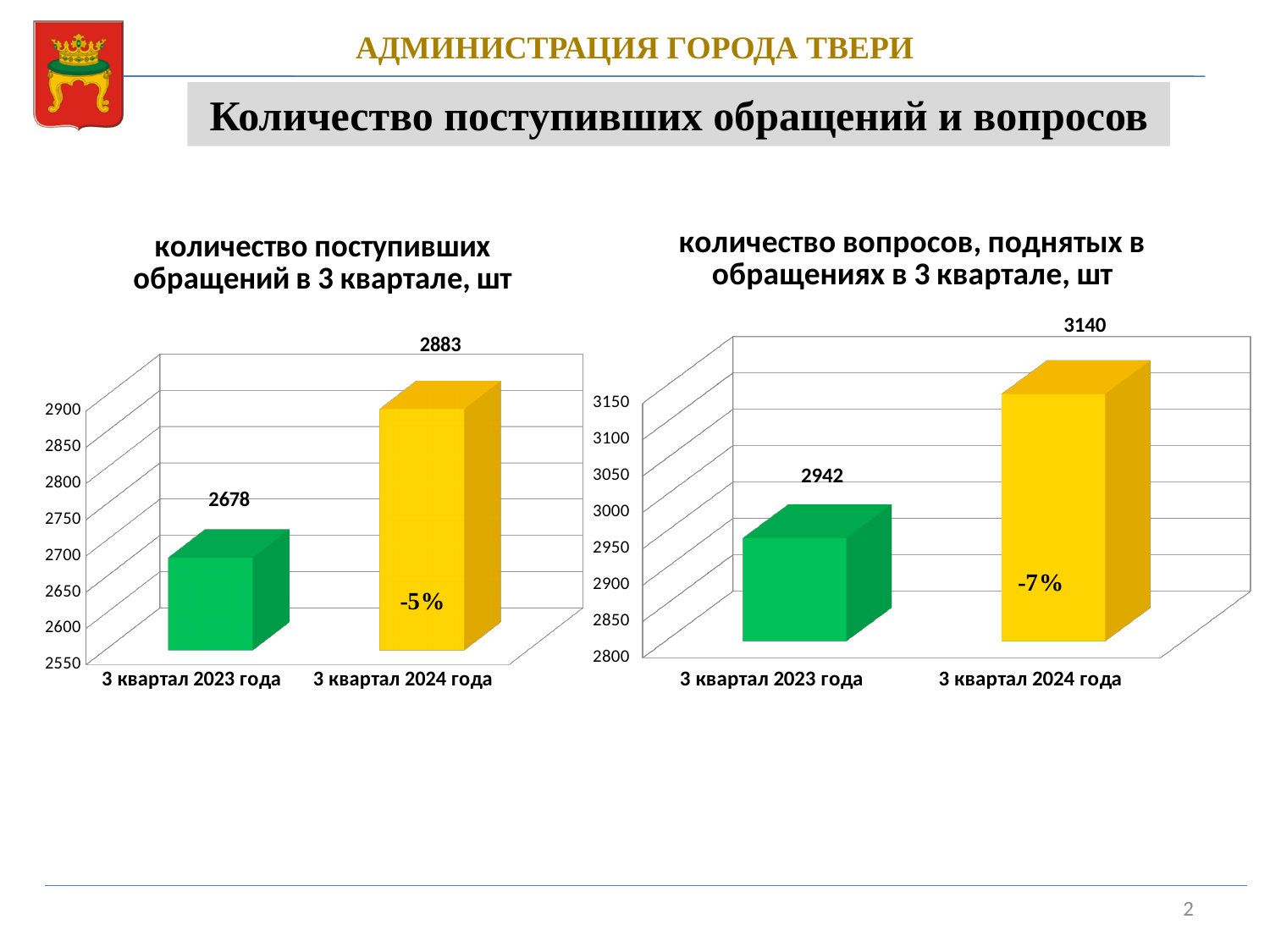
In the right chart, which category has the lowest value? 3 квартал 2023 года In the right chart, what is the difference between the values for 3 квартал 2024 года and 3 квартал 2023 года? 198 In the left chart (количество поступивших обращений в 3 квартале, шт), what is the value for 3 квартал 2023 года? 2678 What kind of chart is the right chart? bar chart In the right chart, which is larger: the value for 3 квартал 2023 года or 3 квартал 2024 года? 3 квартал 2024 года In the left chart, what is the difference between the values for 3 квартал 2024 года and 3 квартал 2023 года? 205 In the right chart (количество вопросов, поднятых в обращениях в 3 квартале, шт), what is the value for 3 квартал 2024 года? 3140 In the left chart, which category has the highest value? 3 квартал 2024 года In the left chart, what percentage label is printed on the bar for 3 квартал 2024 года? -5% In the left chart (количество поступивших обращений в 3 квартале, шт), what is the value for 3 квартал 2024 года? 2883 How many categories are shown in the left chart? 2 In the right chart (количество вопросов, поднятых в обращениях в 3 квартале, шт), what is the value for 3 квартал 2023 года? 2942